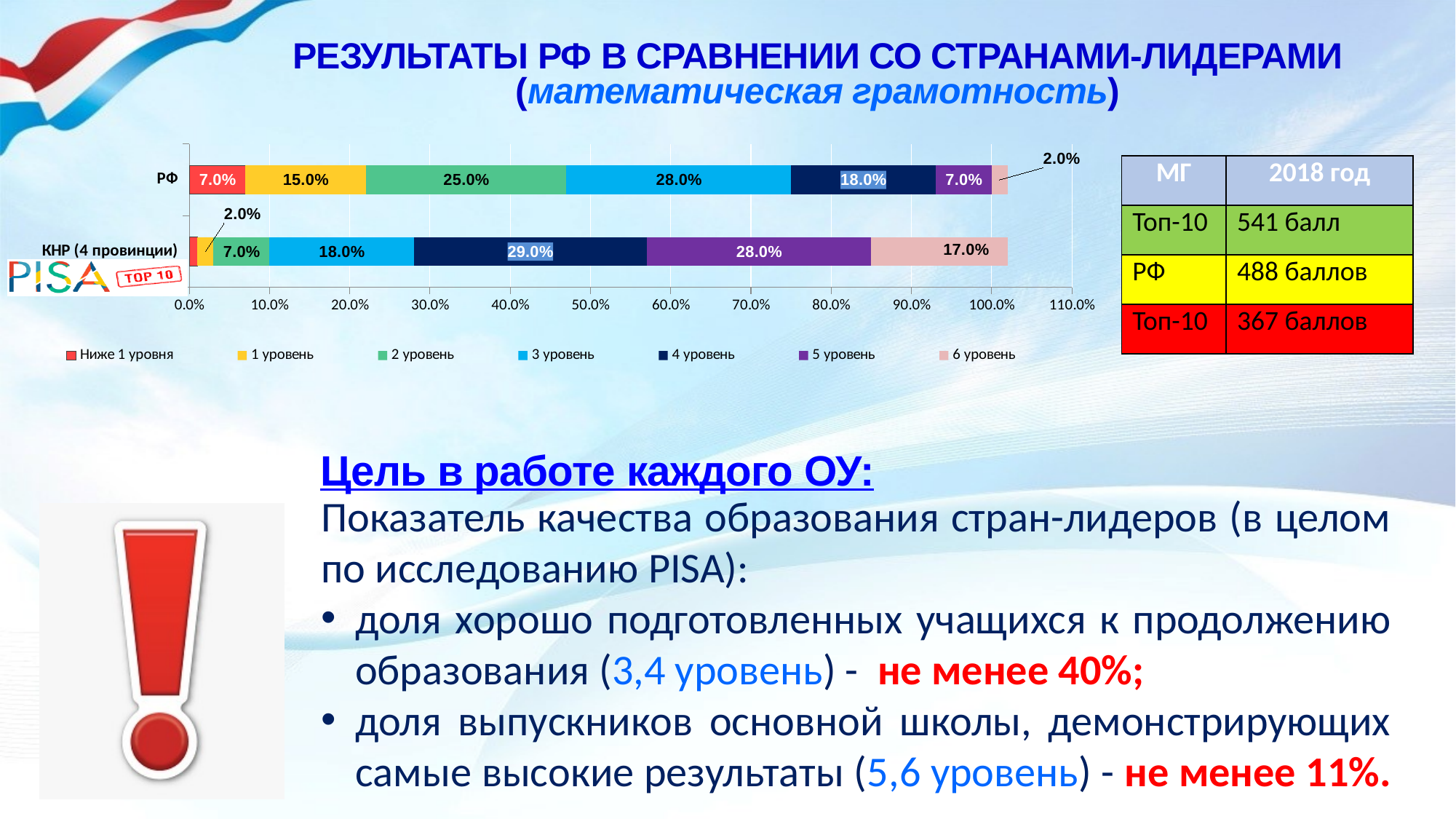
What is the difference between the 2 уровень values for РФ and КНР (4 провинции)? 18.0 percentage points What is the value for the 6 уровень segment of the КНР (4 провинции) bar? 17.0% What is the value for the 6 уровень segment of the РФ bar? 2.0% Which level has the largest share in the РФ bar? 3 уровень What is the difference between the 6 уровень values for КНР (4 провинции) and РФ? 15.0 percentage points What kind of chart is shown on the slide? Stacked bar chart Which has the larger 5 уровень share, РФ or КНР (4 провинции)? КНР (4 провинции) What is the value for the 1 уровень segment of the РФ bar? 15.0% What is the value for the 4 уровень segment of the КНР (4 провинции) bar? 29.0% How many series does the chart legend list? 7 Which level has the largest share in the КНР (4 провинции) bar? 4 уровень What is the value for the 3 уровень segment of the РФ bar? 28.0%